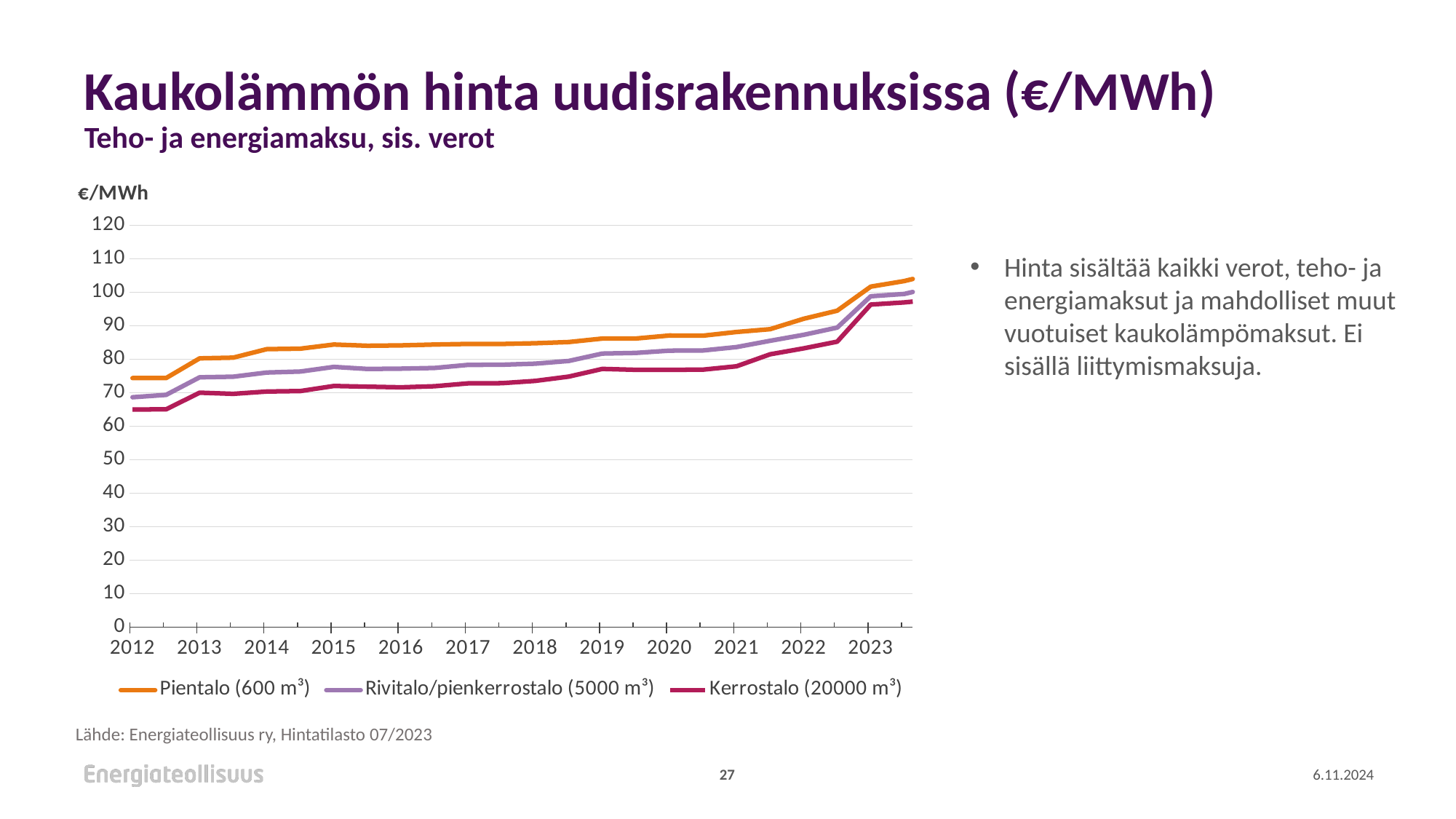
Is the value for Pientalo (600 m³) in 2012 greater or less than 70? greater Is the value for Rivitalo/pienkerrostalo (5000 m³) in 2012 greater or less than 70? less In 2018, which is higher: Pientalo (600 m³) or Kerrostalo (20000 m³)? Pientalo (600 m³) What kind of chart is shown on the slide? line chart What unit is shown on the y axis of the chart? €/MWh Is the value for Kerrostalo (20000 m³) at the last point of the series greater or less than 100? less Which series is plotted with the orange line? Pientalo (600 m³) Do the values for Pientalo (600 m³) generally rise or fall from 2012 to 2023? rise How many series does the legend list? 3